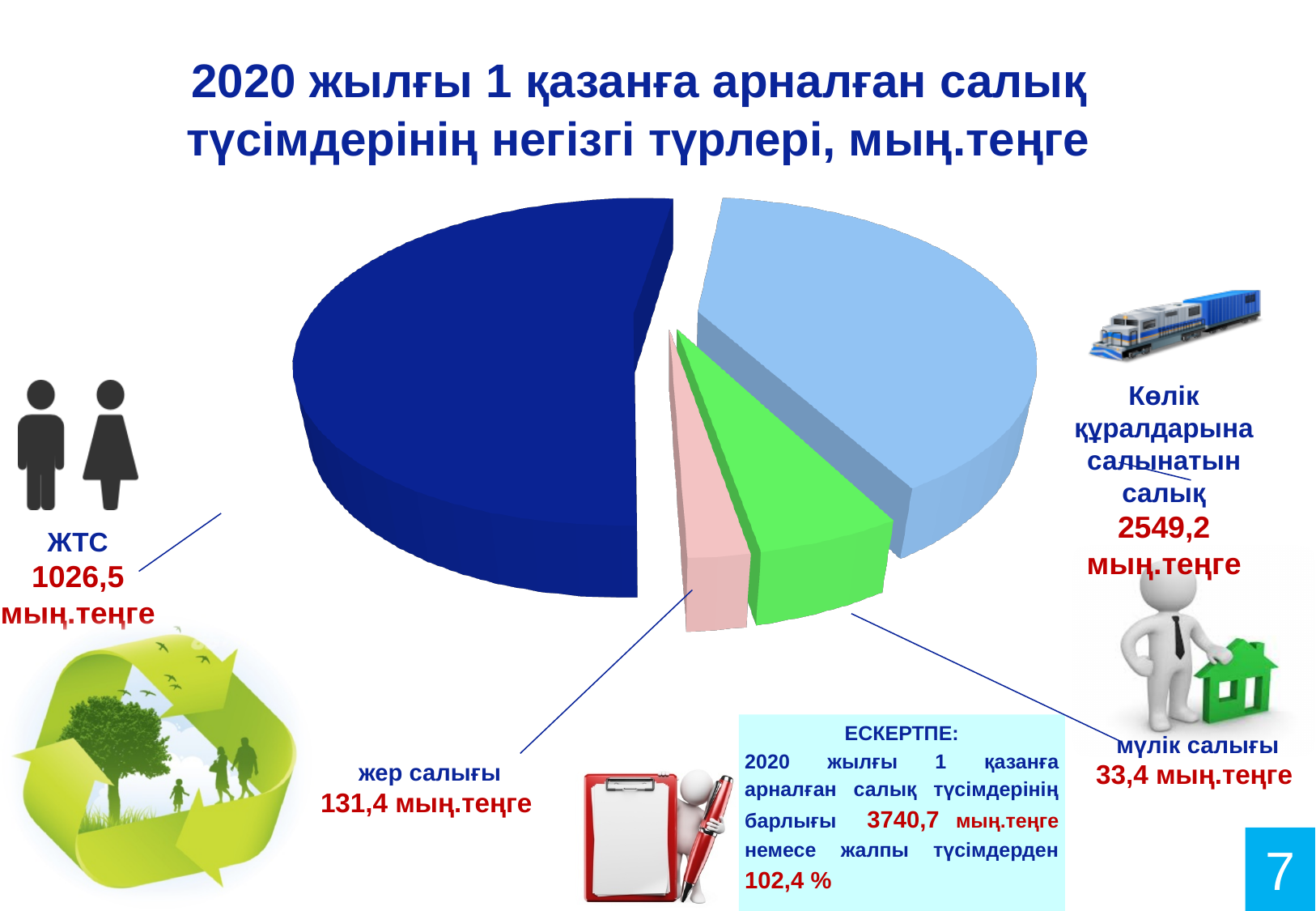
What is the value shown for жер салығы? 131,4 мың.теңге In what units are the values on the chart expressed, according to the title? мың.теңге What is the value shown for Көлік құралдарына салынатын салық? 2549,2 мың.теңге What is the value shown for мүлік салығы? 33,4 мың.теңге What is the difference between the values for жер салығы and мүлік салығы? 98 мың.теңге According to the printed values, which tax type has the lowest value? мүлік салығы What kind of chart is shown on the slide? pie chart According to the printed values, which tax type has the highest value? Көлік құралдарына салынатын салық What is the value shown for ЖТС? 1026,5 мың.теңге What is the difference between the values for Көлік құралдарына салынатын салық and ЖТС? 1522,7 мың.теңге How many slices does the pie chart have? 4 Which is larger according to the printed values: ЖТС or жер салығы? ЖТС